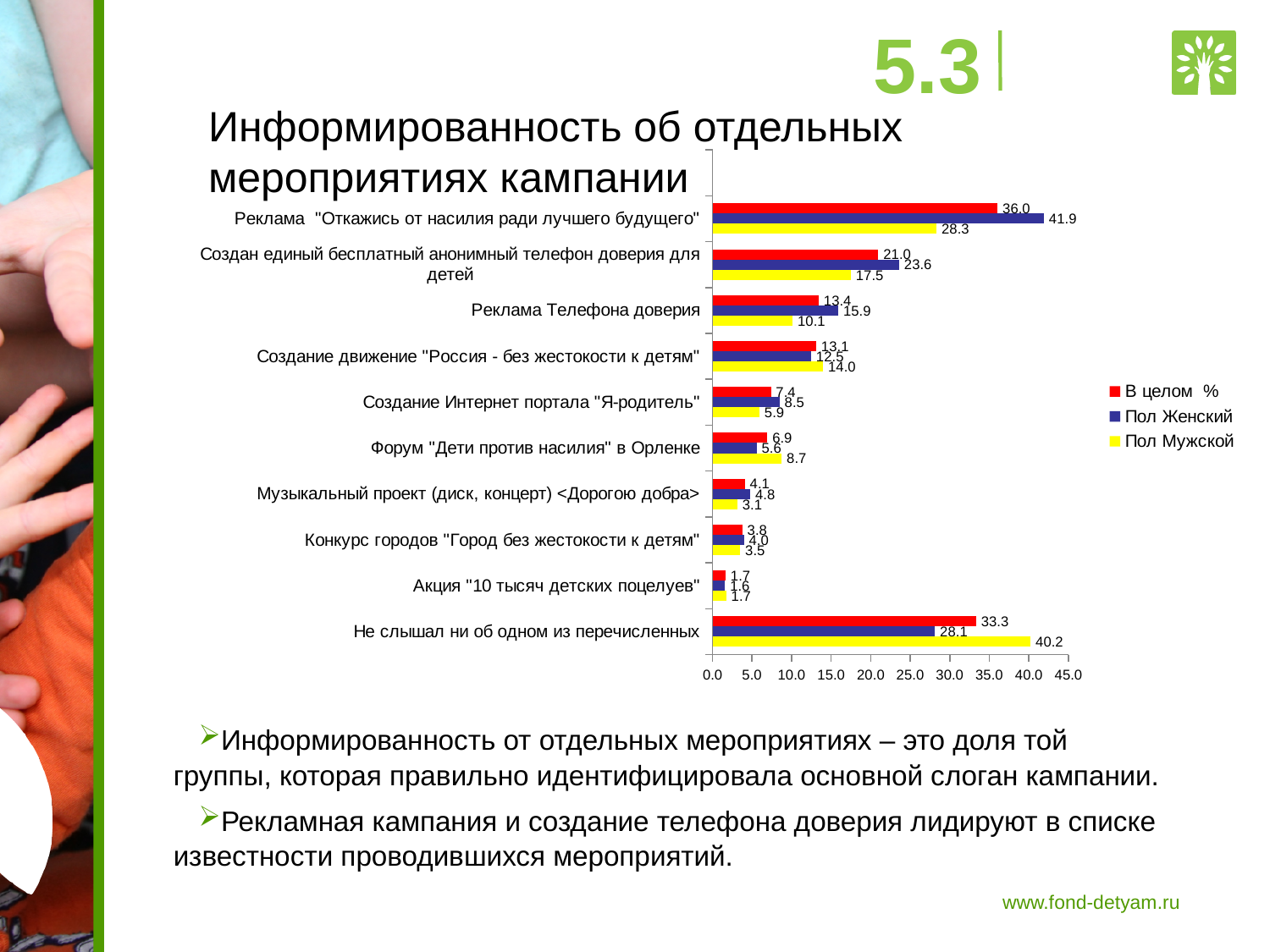
How many series does the legend list? 3 For "Форум "Дети против насилия" в Орленке", which is larger: the "Пол Женский" value or the "Пол Мужской" value? Пол Мужской Which category has the lowest "В целом %" value? Акция "10 тысяч детских поцелуев" How many categories are shown on the chart? 10 What is the value of "Пол Мужской" for "Не слышал ни об одном из перечисленных"? 40.2 What is the value of "Пол Женский" for "Реклама Телефона доверия"? 15.9 Is the "Пол Мужской" value for "Создан единый бесплатный анонимный телефон доверия для детей" greater or less than 20.0? less What is the difference between the "Пол Женский" and "Пол Мужской" values for "Реклама "Откажись от насилия ради лучшего будущего""? 13.6 What kind of chart is shown on the slide? Bar chart Which category has the highest "Пол Женский" value? Реклама "Откажись от насилия ради лучшего будущего" Which colour represents the "Пол Мужской" series? Yellow What is the value of "В целом %" for "Реклама "Откажись от насилия ради лучшего будущего""? 36.0